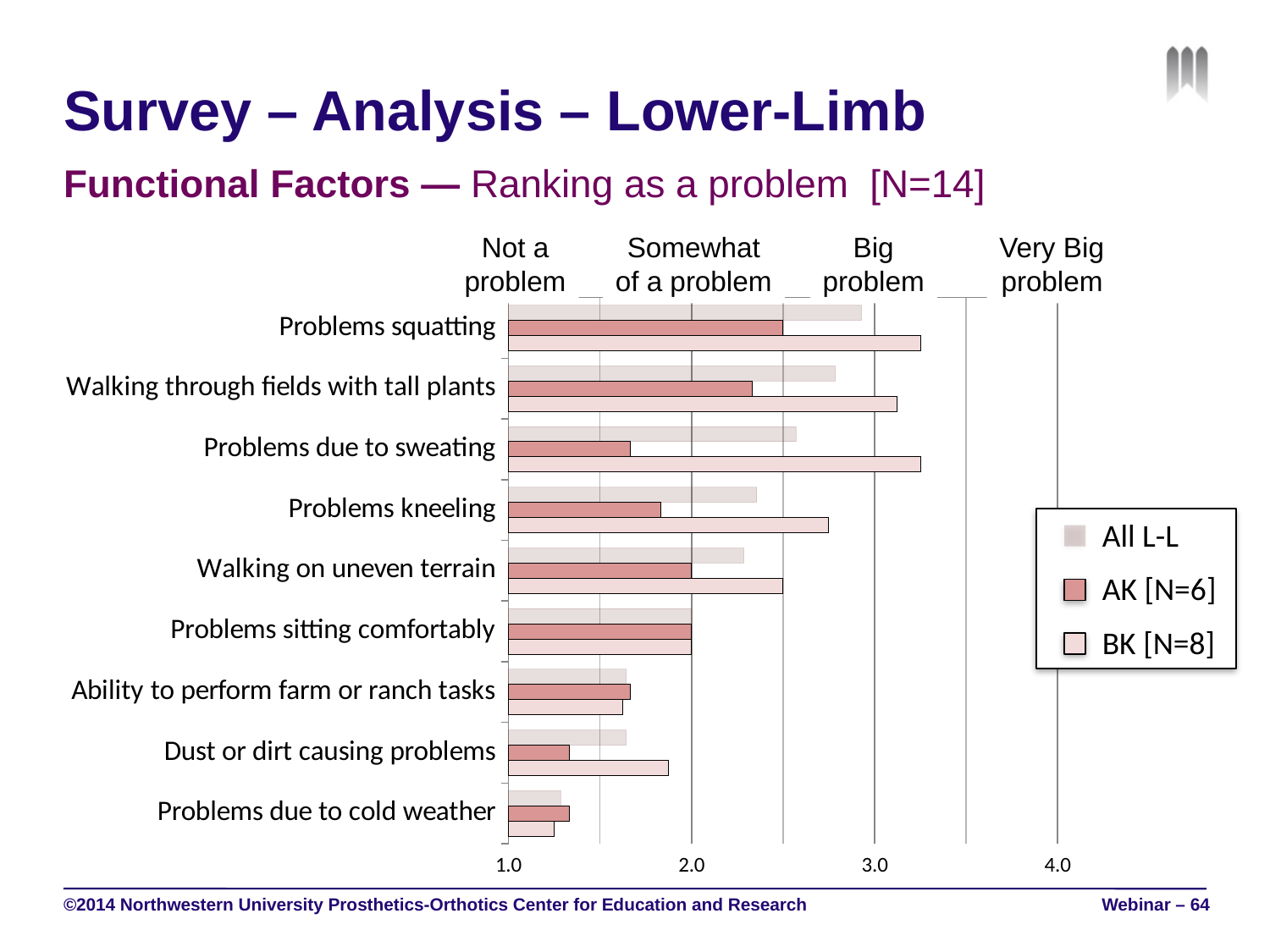
What is the value for all three series for 'Problems sitting comfortably'? 2.0 Is the BK [N=8] value for 'Problems kneeling' greater or less than 2.0? greater For 'Problems due to sweating', which is larger: the AK [N=6] value or the BK [N=8] value? BK [N=8] Is the BK [N=8] value for 'Problems squatting' greater or less than 3.0? greater Which category has the highest All L-L value? Problems squatting What are the three series named in the legend? All L-L, AK [N=6], BK [N=8] How many functional factor categories are plotted on the chart? 9 What kind of chart is shown on the slide? bar chart How many series does the legend list? 3 Is the AK [N=6] value for 'Problems due to sweating' greater or less than 2.0? less For 'Problems kneeling', which is larger: the AK [N=6] value or the BK [N=8] value? BK [N=8] Which category has the lowest All L-L value? Problems due to cold weather